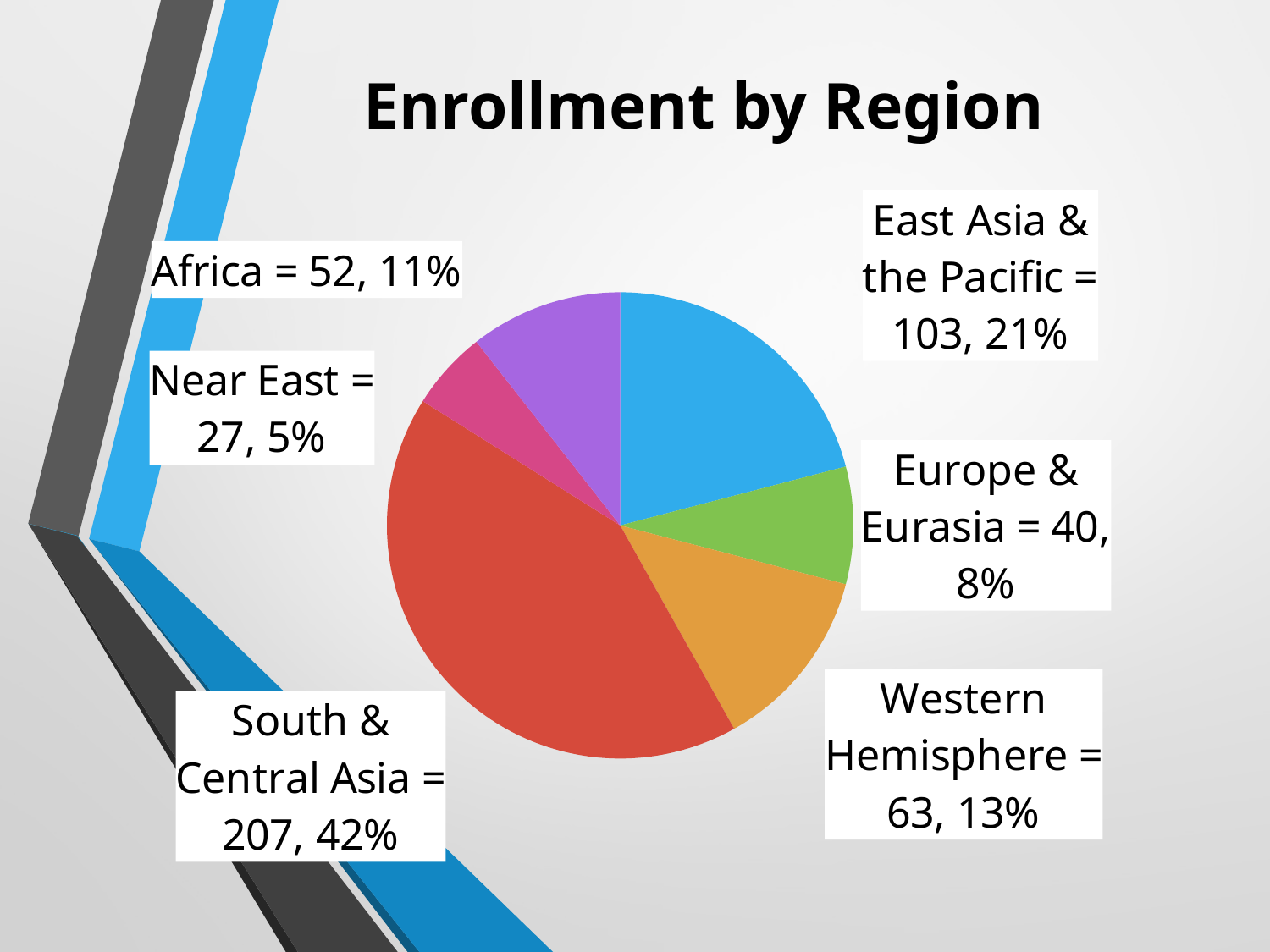
What type of chart is shown on the slide? pie chart What is the enrollment value for Near East? 27 What is the enrollment value for East Asia & the Pacific? 103 Which has a higher enrollment, Western Hemisphere or Europe & Eurasia? Western Hemisphere What percentage share of enrollment does Africa have? 11% Which region has the largest share of enrollment? South & Central Asia What percentage share of enrollment does Western Hemisphere have? 13% What is the title of the chart? Enrollment by Region How many regions are shown in the pie chart? 6 What is the enrollment value for South & Central Asia? 207 Which region has the smallest share of enrollment? Near East What is the difference in enrollment between South & Central Asia and East Asia & the Pacific? 104